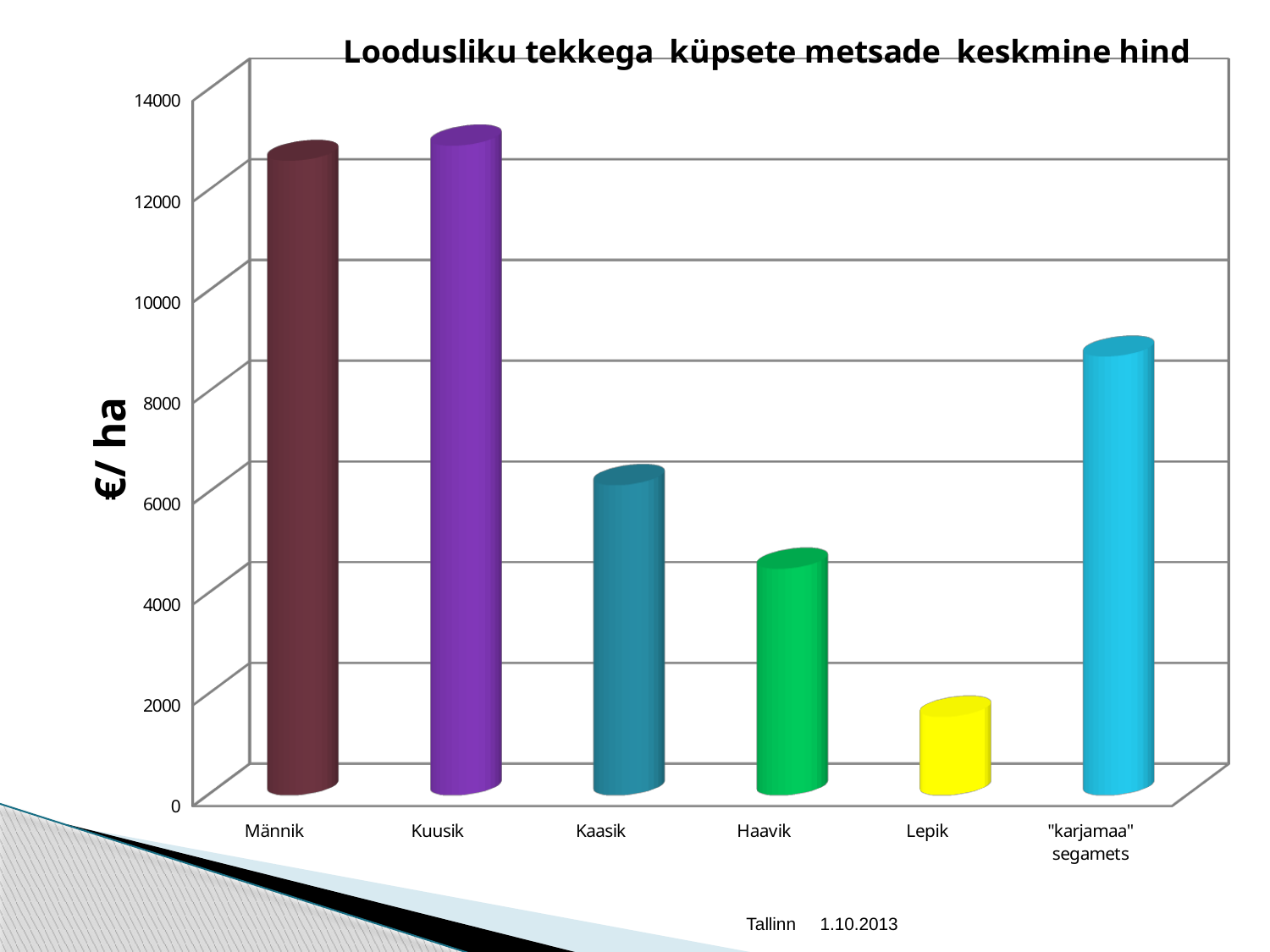
What is the label on the vertical axis of the chart? €/ ha Is the value for Haavik greater or less than 6000? less Which category has the lowest value in the chart? Lepik What kind of chart is shown on the slide? bar chart Is the value for Kuusik greater or less than 10000? greater Is the value for "karjamaa" segamets greater or less than 10000? less Which has a higher value, Kaasik or Haavik? Kaasik How many categories are shown on the x axis of the chart? 6 Which has a higher value, "karjamaa" segamets or Kaasik? "karjamaa" segamets